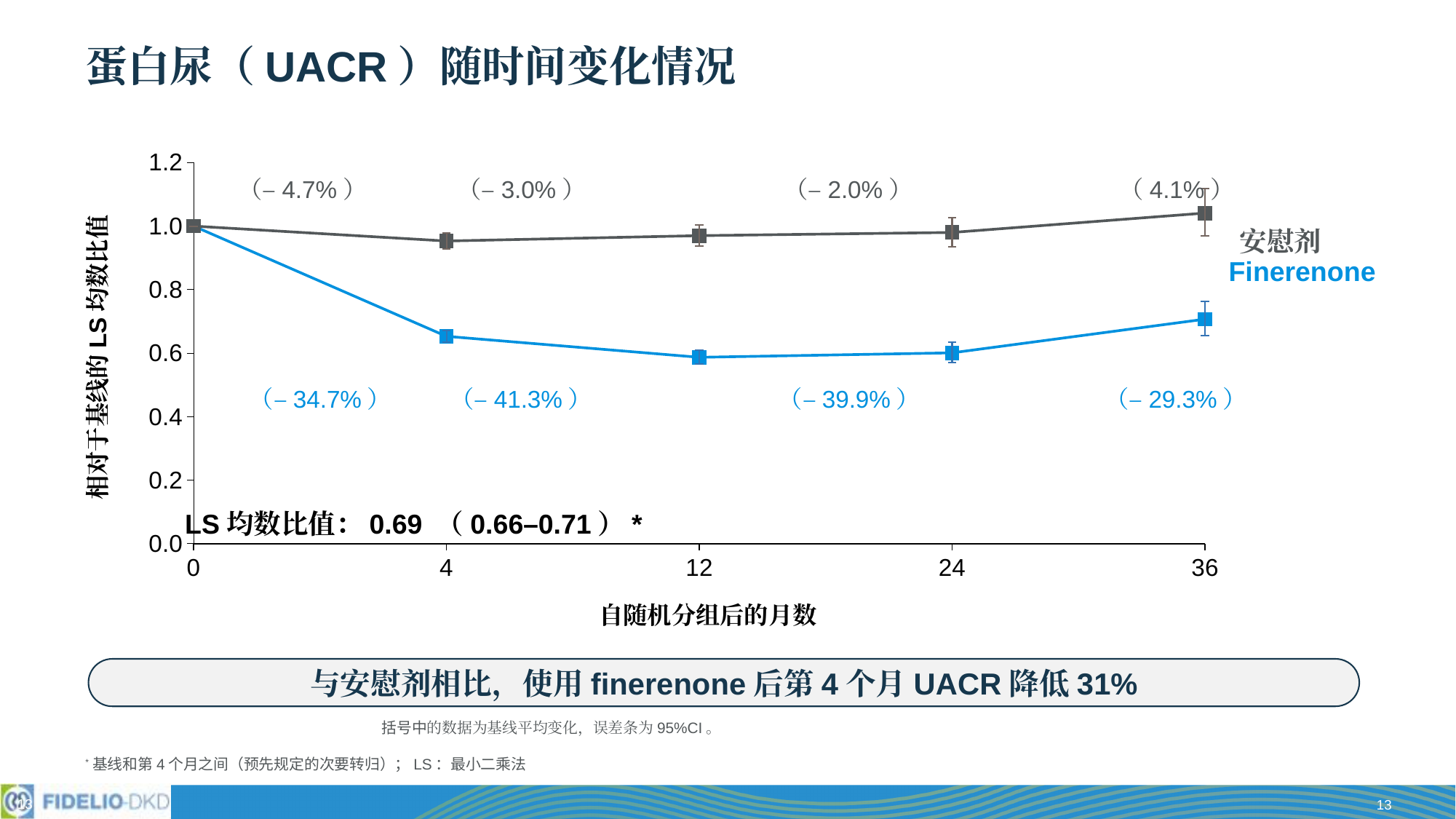
Is the Finerenone value at month 4 greater or less than 0.8? less What percentage change from baseline is labelled for 安慰剂 at month 36 (the last grey label)? 4.1% What LS mean ratio (LS 均数比值) is printed on the chart? 0.69 (0.66–0.71) How many time points are plotted on the x axis for each series? 5 What kind of chart is shown on the slide? line chart What percentage change from baseline is labelled for Finerenone at month 4 (the first blue label)? −34.7% What is the plotted value for both series at month 0? 1.0 What percentage change from baseline is labelled for Finerenone at month 12 (the second blue label)? −41.3% Is the Finerenone value at month 36 greater or less than 0.8? less Does the Finerenone line rise or fall between month 0 and month 12? fall At month 12, which series has the higher value, 安慰剂 or Finerenone? 安慰剂 How many series does the chart show? 2